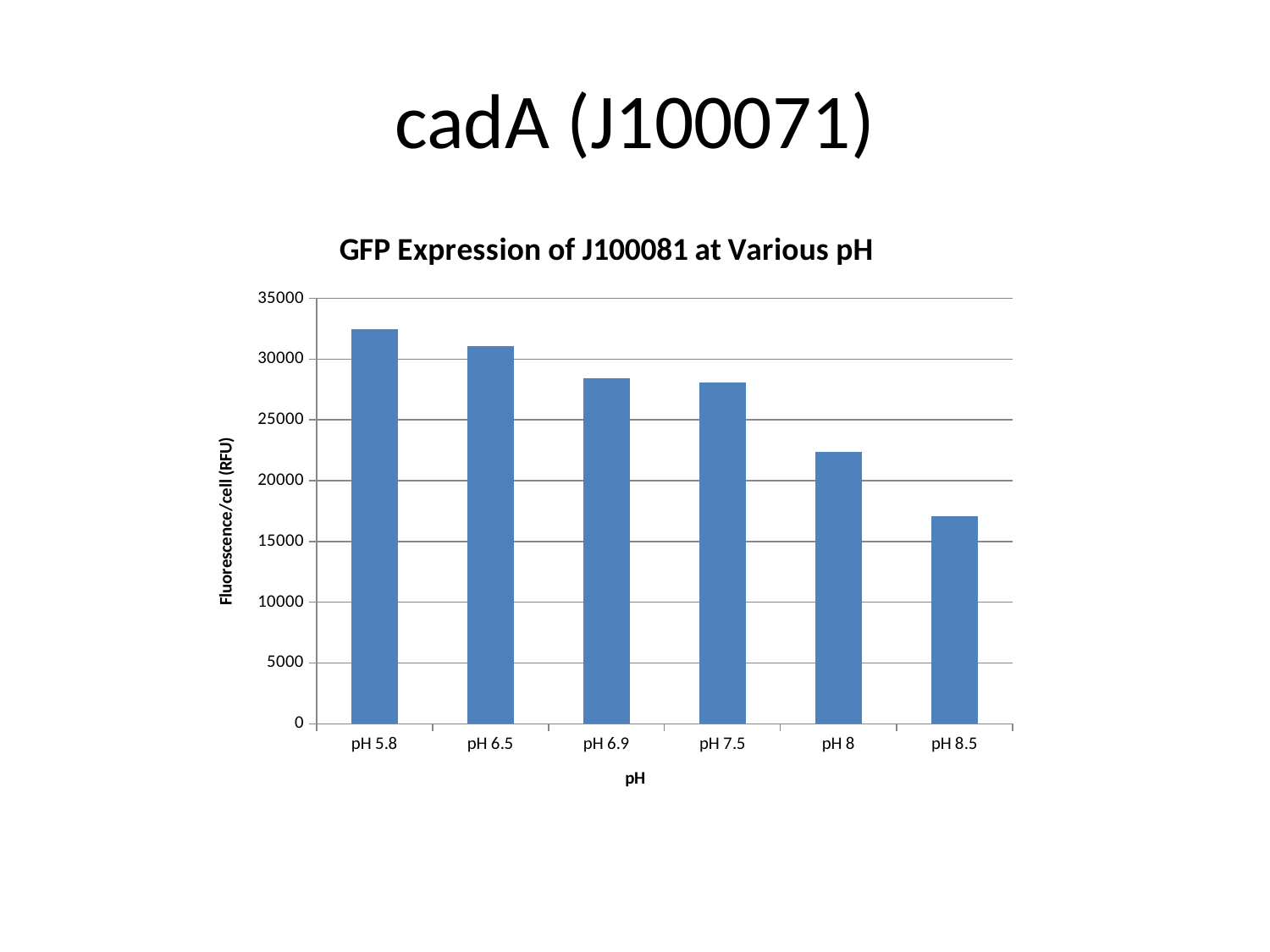
Do the fluorescence values rise or fall as pH increases along the x axis? fall Is the value for pH 6.9 greater or less than 30000? less Which pH has the highest fluorescence per cell? pH 5.8 Is the value for pH 8 greater or less than 20000? greater What kind of chart is shown on the slide? bar chart Which pH has the lowest fluorescence per cell? pH 8.5 Is the value for pH 5.8 greater or less than 30000? greater What is the title of the chart? GFP Expression of J100081 at Various pH Which has a higher fluorescence per cell, pH 8 or pH 8.5? pH 8 How many pH categories are plotted on the chart? 6 What is the label of the y axis? Fluorescence/cell (RFU)